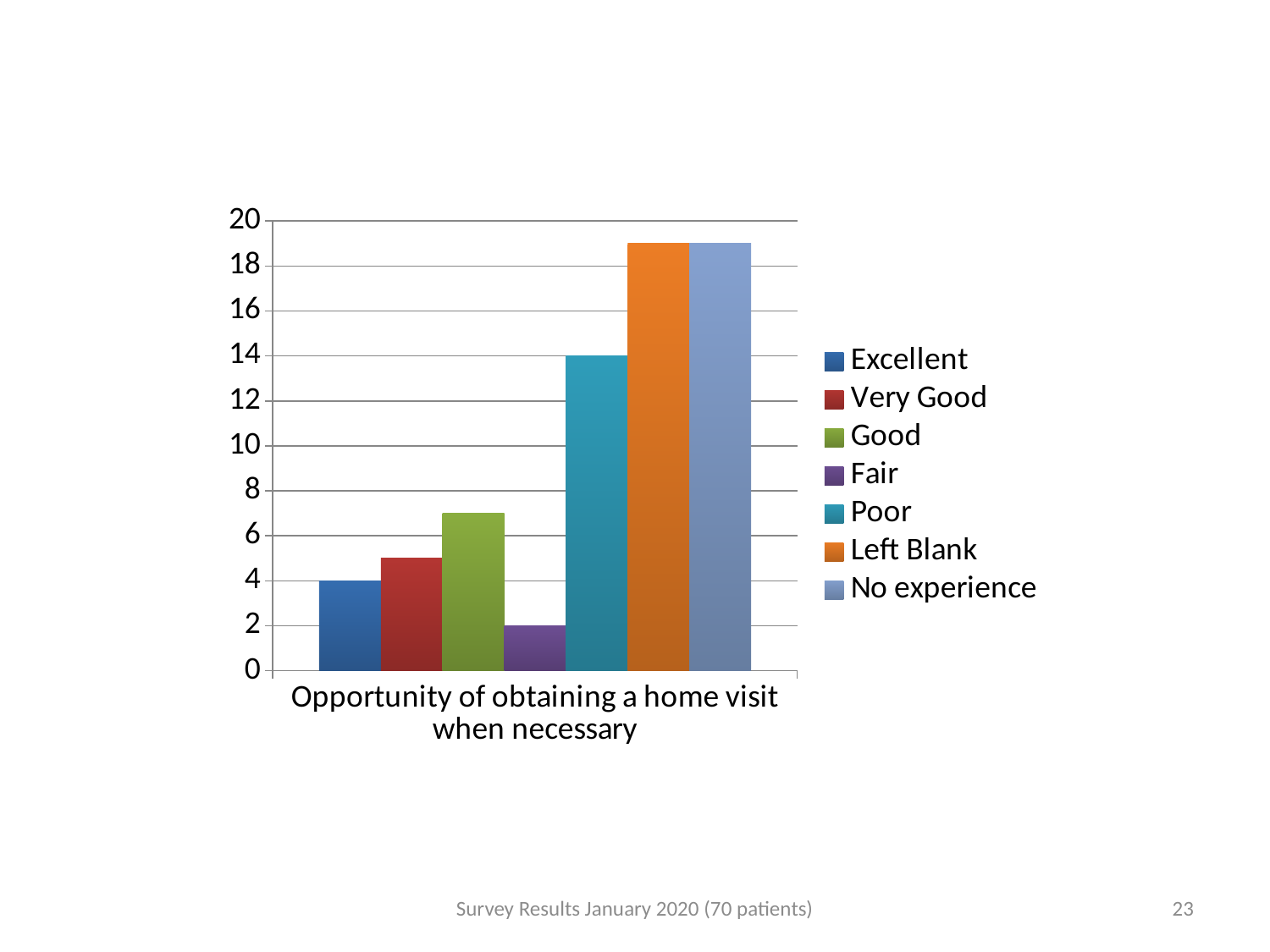
What is the value for Poor? 14 Is the value for Left Blank greater or less than 18? greater Which series has the lowest value? Fair Which is larger, the value for Poor or the value for Good? Poor What is the category label shown on the x axis? Opportunity of obtaining a home visit when necessary What type of chart is shown on the slide? bar chart How many series does the legend list? 7 What is the difference between the values for Poor and Excellent? 10 What is the value for Fair? 2 Is the value for Good greater or less than 8? less How many categories are shown on the x axis? 1 What is the value for Excellent? 4